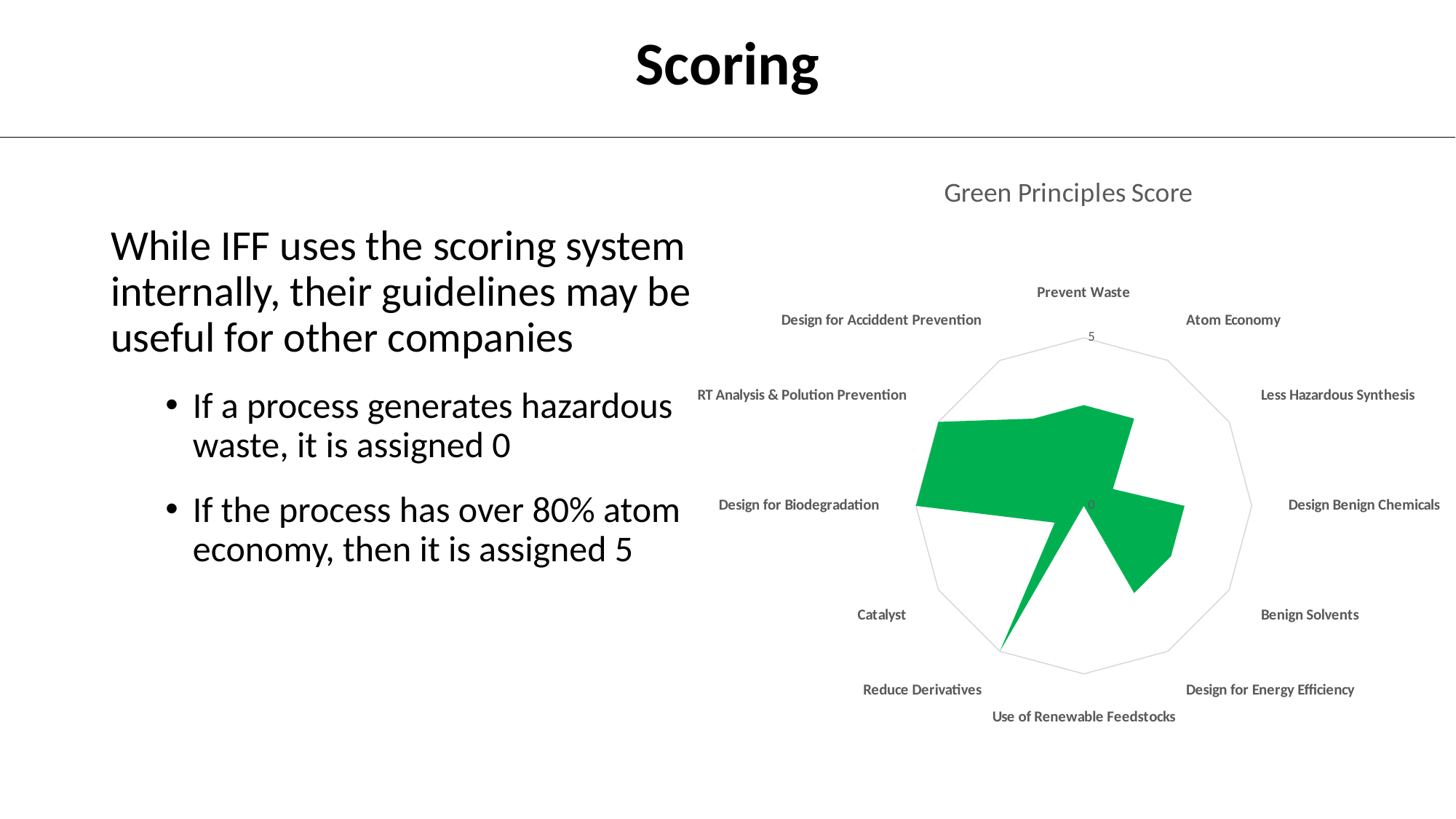
What is the title of the chart? Green Principles Score What is the score for Design for Biodegradation? 5 What is the score for Use of Renewable Feedstocks? 0 What is the score for Reduce Derivatives? 5 What is the score for RT Analysis & Polution Prevention? 5 Which has the higher score, Prevent Waste or Catalyst? Prevent Waste How many categories (axes) does the radar chart have? 12 Which has the higher score, Design for Biodegradation or Benign Solvents? Design for Biodegradation What type of chart is shown on the slide? Radar chart What is the maximum value shown on the chart's scale? 5